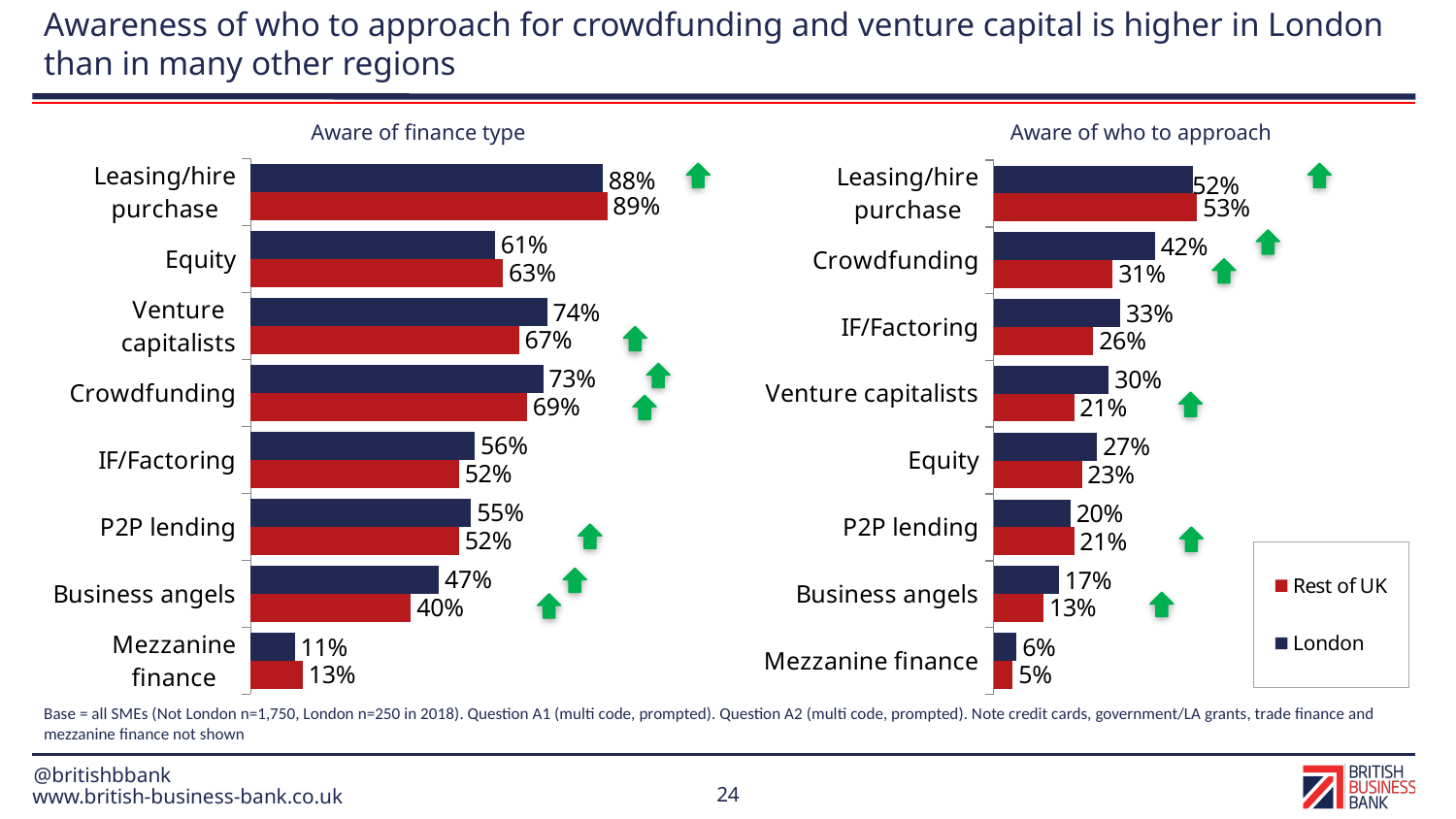
In the 'Aware of finance type' chart, what is the value for London for Venture capitalists? 74% How many categories are shown in the 'Aware of who to approach' chart? 8 In the 'Aware of finance type' chart, what is the difference between the London and Rest of UK values for Business angels? 7 percentage points In the 'Aware of who to approach' chart, what is the value for Rest of UK for Venture capitalists? 21% What type of chart is the 'Aware of finance type' chart? Bar chart In the 'Aware of who to approach' chart, what is the value for London for Crowdfunding? 42% In the 'Aware of who to approach' chart, which category has the lowest value for London? Mezzanine finance In the 'Aware of finance type' chart, what is the value for Rest of UK for Business angels? 40% In the 'Aware of who to approach' chart, what is the difference between the London and Rest of UK values for Crowdfunding? 11 percentage points In the 'Aware of finance type' chart, which category has the highest value for Rest of UK? Leasing/hire purchase How many series does the legend list? 2 In the 'Aware of finance type' chart, which is larger for Crowdfunding: the London value or the Rest of UK value? London